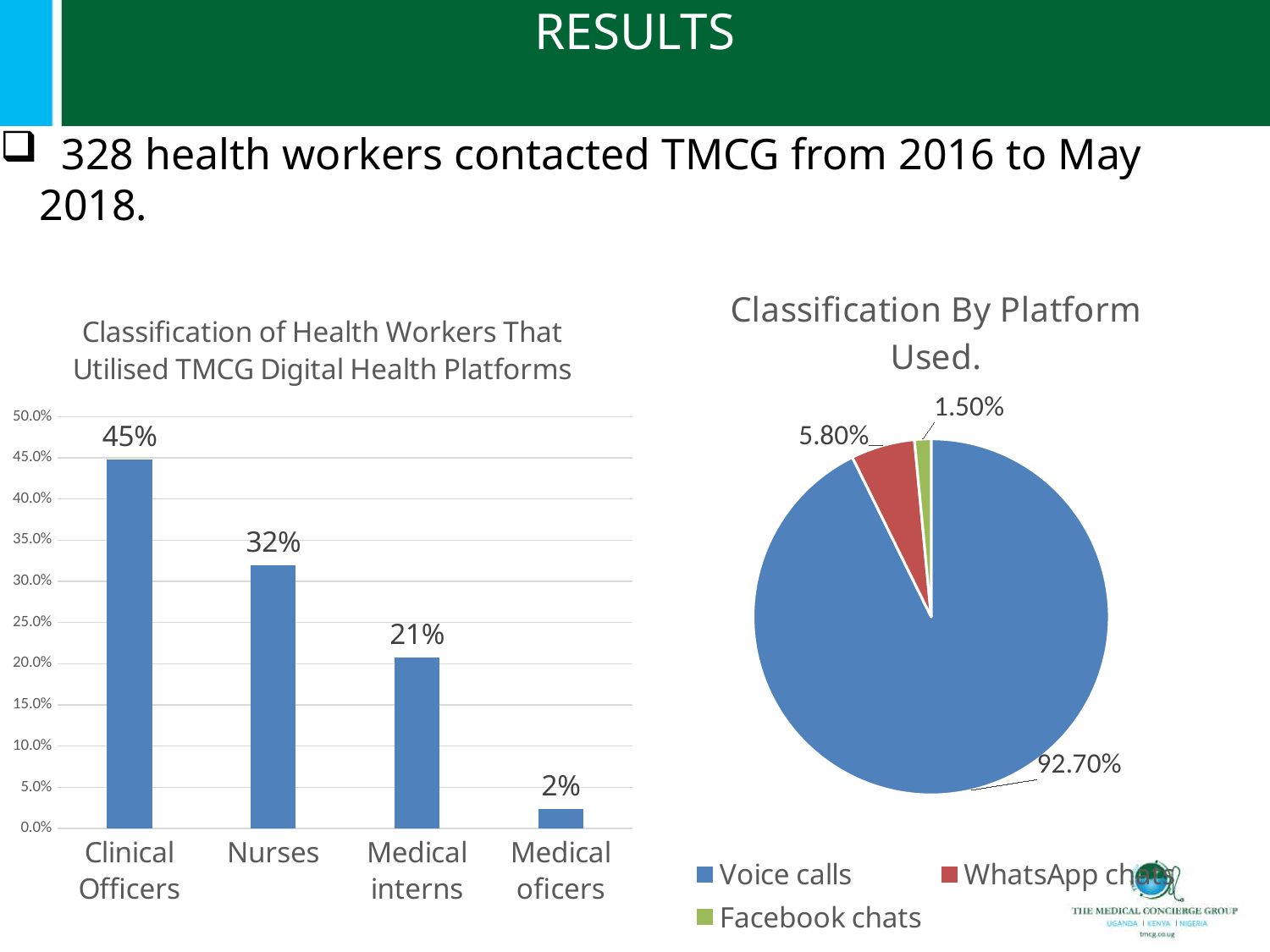
In the 'Classification of Health Workers That Utilised TMCG Digital Health Platforms' chart, which is larger, the value for Nurses or the value for Medical interns? Nurses In the 'Classification of Health Workers That Utilised TMCG Digital Health Platforms' chart, how many categories are shown on the x axis? 4 In the 'Classification By Platform Used.' chart, what is the value for WhatsApp chats? 5.80% In the 'Classification of Health Workers That Utilised TMCG Digital Health Platforms' chart, which category has the highest value? Clinical Officers In the 'Classification of Health Workers That Utilised TMCG Digital Health Platforms' chart, what is the value for Medical interns? 21% In the 'Classification of Health Workers That Utilised TMCG Digital Health Platforms' chart, do the values rise or fall from left to right along the x axis? Fall In the 'Classification of Health Workers That Utilised TMCG Digital Health Platforms' chart, which category has the lowest value? Medical oficers In the 'Classification of Health Workers That Utilised TMCG Digital Health Platforms' chart, what is the difference between the values for Clinical Officers and Nurses? 13% What kind of chart is the 'Classification of Health Workers That Utilised TMCG Digital Health Platforms' chart? Bar chart In the 'Classification By Platform Used.' chart, how many entries does the legend list? 3 In the 'Classification of Health Workers That Utilised TMCG Digital Health Platforms' chart, what is the value for Clinical Officers? 45% In the 'Classification By Platform Used.' chart, what share of the pie is Voice calls? 92.70%